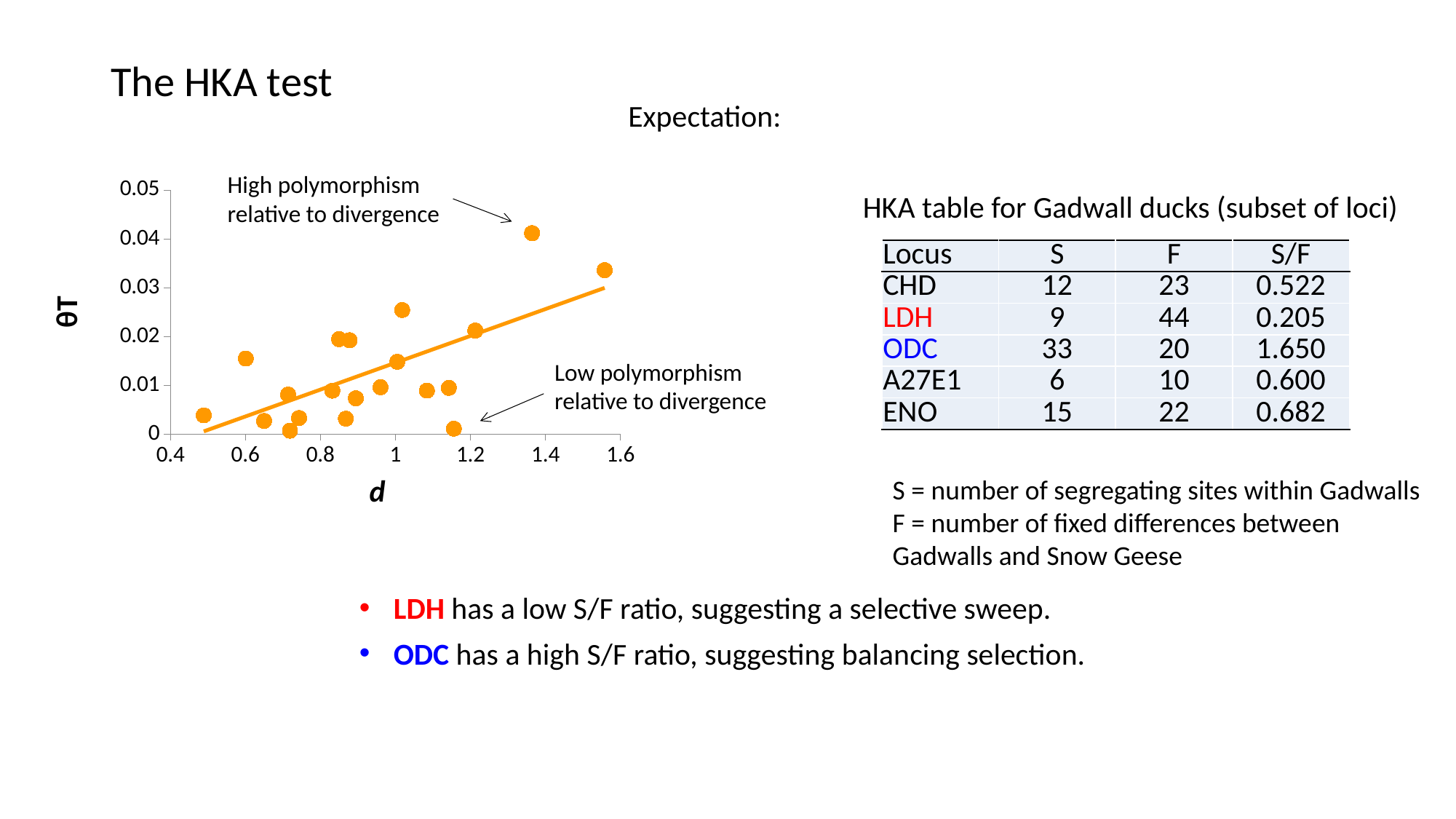
Is the θT value of the point labelled 'Low polymorphism relative to divergence' greater or less than 0.01? less Is the d value of the point labelled 'Low polymorphism relative to divergence' greater or less than 1.4? less What kind of chart is shown on the slide? scatter chart Which of the two annotated points has the higher θT value: the 'High polymorphism' point or the 'Low polymorphism' point? High polymorphism What is the label of the y axis of the chart? θT Is the θT value of the point labelled 'High polymorphism relative to divergence' greater or less than 0.03? greater What is the label of the x axis of the chart? d What is the highest tick value shown on the y axis of the chart? 0.05 Do the plotted θT values generally rise or fall as d increases along the x axis? rise